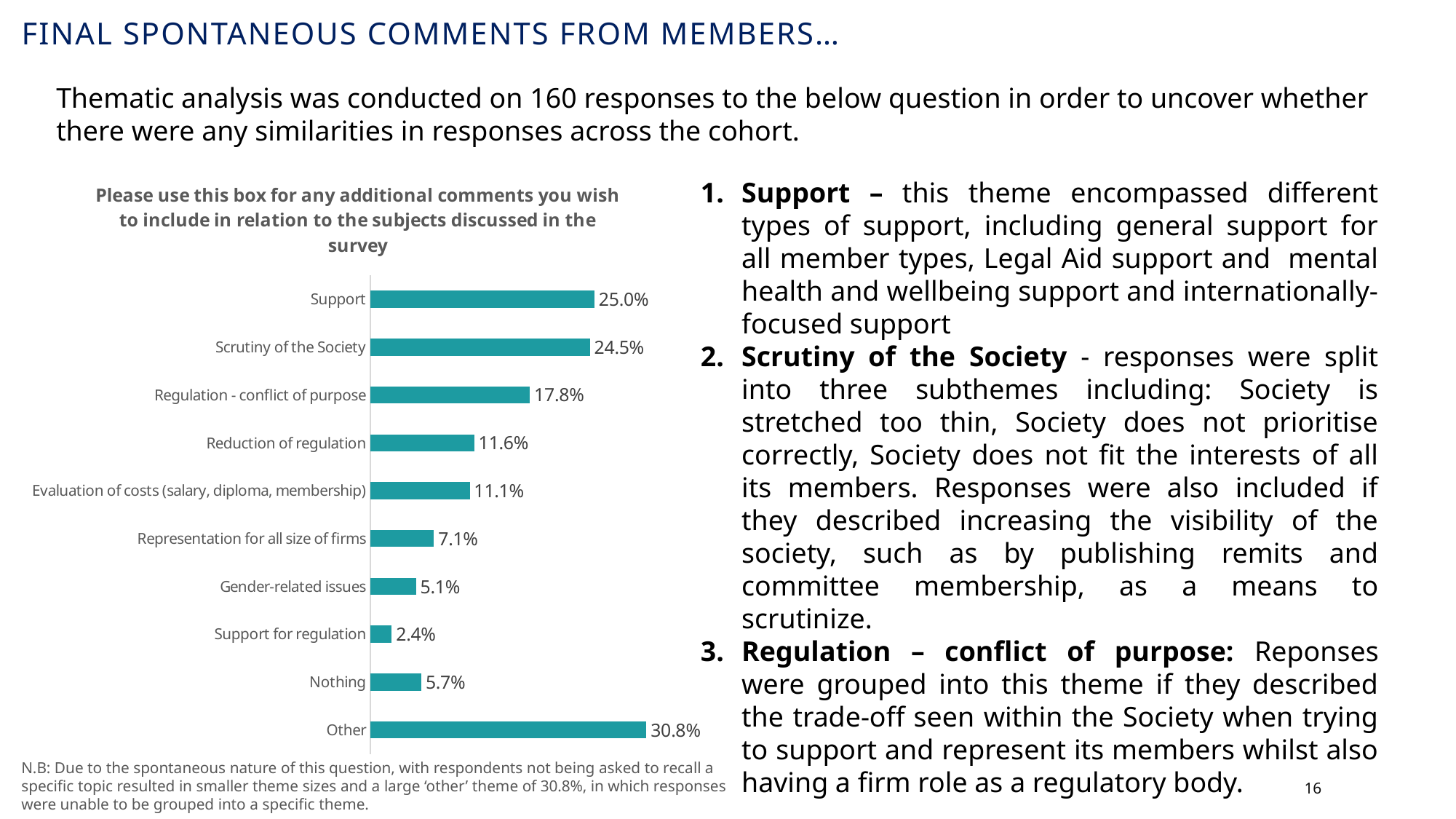
What is the value for Gender-related issues? 5.1% How many categories are shown in the chart? 10 What is the title of the chart? Please use this box for any additional comments you wish to include in relation to the subjects discussed in the survey What kind of chart is shown on the slide? Bar chart Which category has the highest value? Other Which is larger, the value for Reduction of regulation or the value for Representation for all size of firms? Reduction of regulation What is the difference between the values for Other and Nothing? 25.1% Which is larger, the value for Nothing or the value for Gender-related issues? Nothing What is the value for Support? 25.0% What is the difference between the values for Support and Scrutiny of the Society? 0.5% Which category has the lowest value? Support for regulation What is the value for Regulation - conflict of purpose? 17.8%